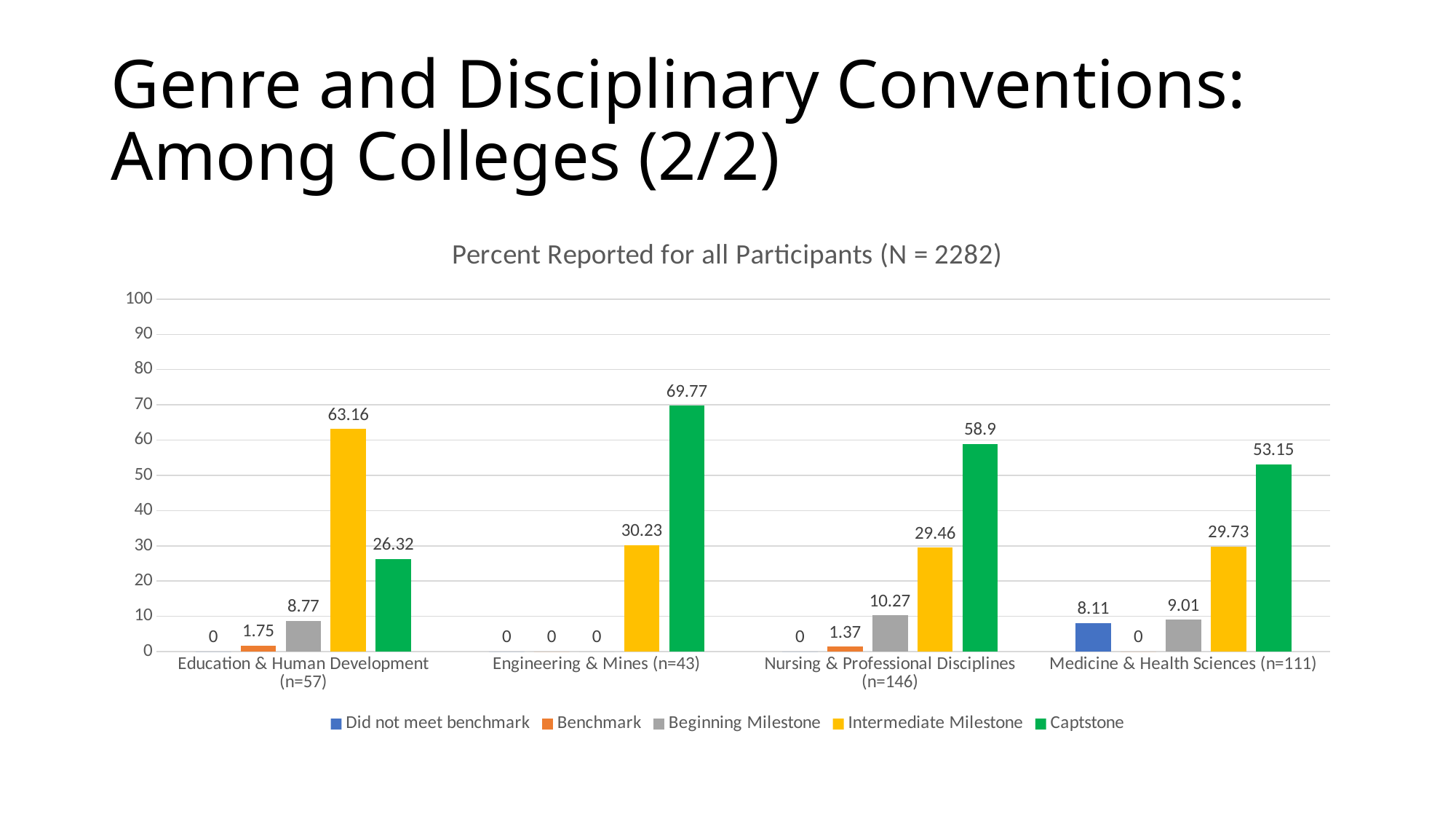
What is the Beginning Milestone value for Nursing & Professional Disciplines (n=146)? 10.27 What is the Did not meet benchmark value for Medicine & Health Sciences (n=111)? 8.11 What kind of chart is shown on the slide? Bar chart What is the title of the chart? Percent Reported for all Participants (N = 2282) How many colleges are shown on the x axis? 4 What is the difference between the Captstone values for Nursing & Professional Disciplines (n=146) and Medicine & Health Sciences (n=111)? 5.75 Which college has the highest Captstone value? Engineering & Mines (n=43) What is the Intermediate Milestone value for Education & Human Development (n=57)? 63.16 How many series does the legend list? 5 Which is larger: the Intermediate Milestone value for Engineering & Mines (n=43) or for Nursing & Professional Disciplines (n=146)? Engineering & Mines (n=43) Which college has the lowest Captstone value? Education & Human Development (n=57) What is the Captstone value for Engineering & Mines (n=43)? 69.77